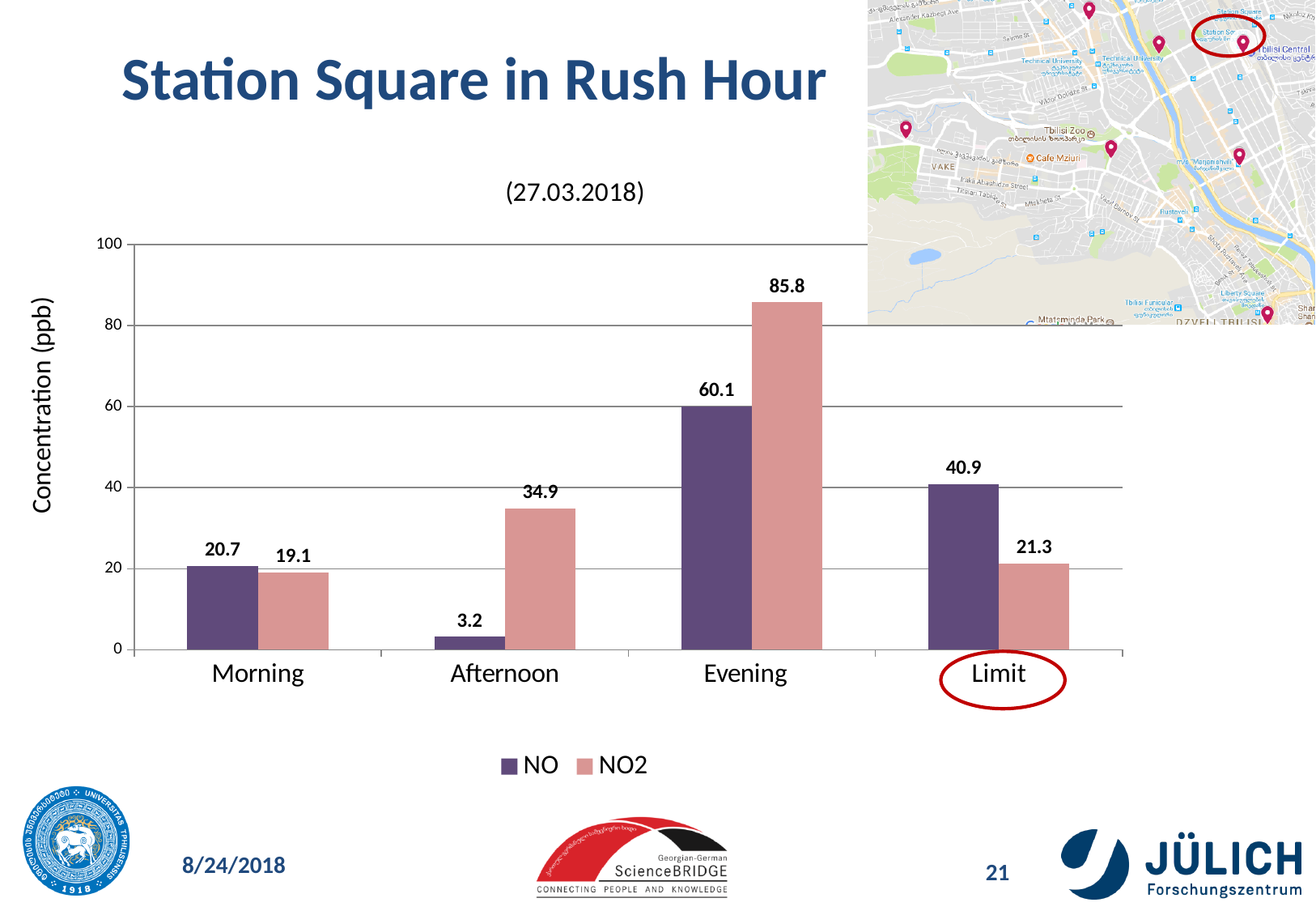
Is the NO2 value for Limit greater or less than 40? less What is the label of the y axis? Concentration (ppb) Which category has the lowest NO value? Afternoon How many categories are shown on the x axis? 4 What is the difference between the NO2 and NO values in the Evening? 25.7 How many series does the legend list? 2 Which category has the highest NO2 value? Evening What is the NO concentration in the Morning? 20.7 What is the NO value for the Limit category? 40.9 What is the NO2 concentration in the Evening? 85.8 What kind of chart is shown on the slide? bar chart Which is larger in the Afternoon, NO or NO2? NO2